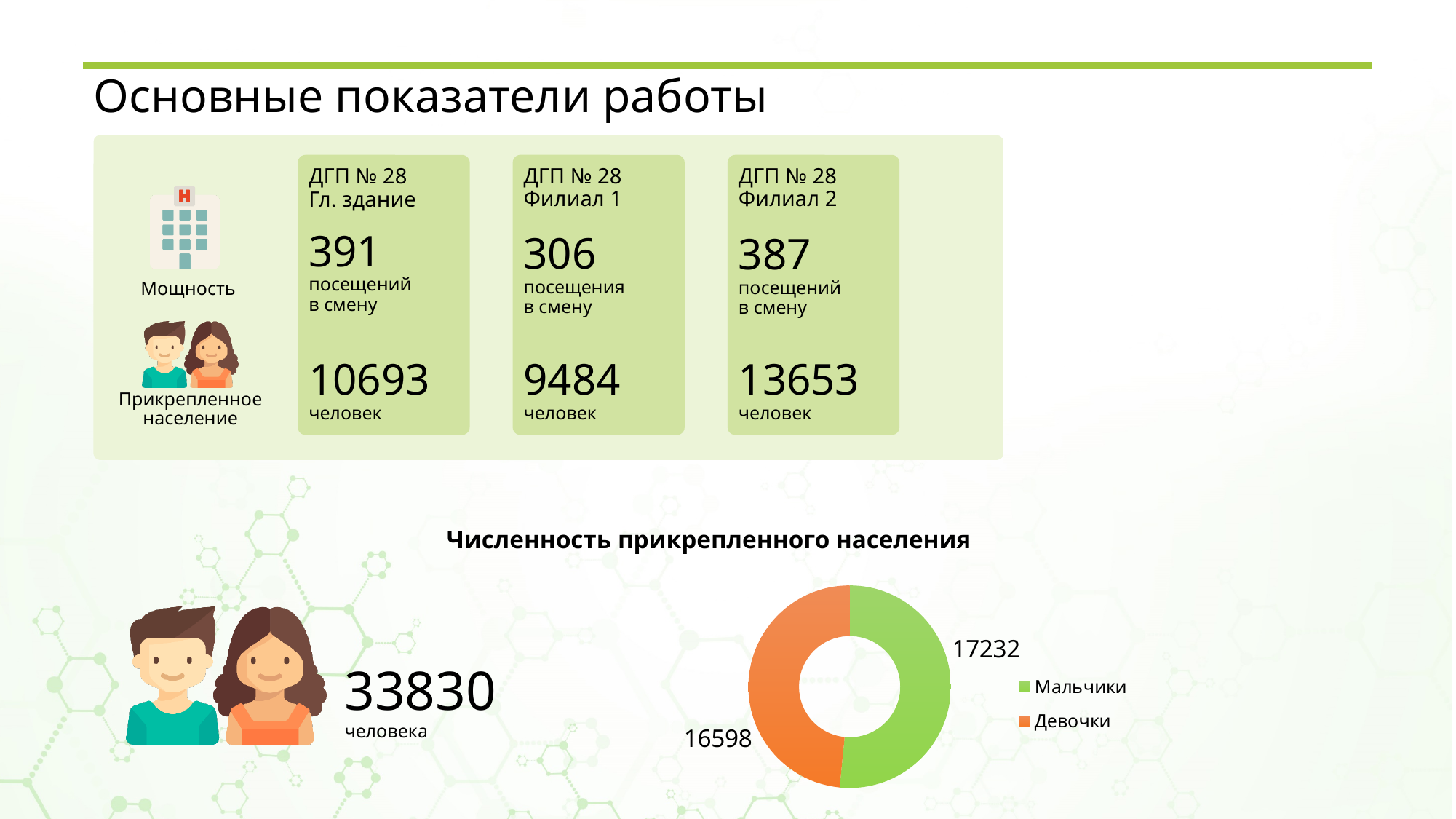
What is the value for Девочки in the chart 'Численность прикрепленного населения'? 16598 What kind of chart is 'Численность прикрепленного населения'? doughnut chart Which category has the smaller value in the chart 'Численность прикрепленного населения'? Девочки What is the total of the two slices in the chart 'Численность прикрепленного населения'? 33830 Which colour represents Девочки in the chart 'Численность прикрепленного населения'? orange How many categories are shown in the chart 'Численность прикрепленного населения'? 2 In the chart 'Численность прикрепленного населения', what is the difference between the values for Мальчики and Девочки? 634 What is the value for Мальчики in the chart 'Численность прикрепленного населения'? 17232 In the chart 'Численность прикрепленного населения', is the value for Мальчики larger or smaller than the value for Девочки? larger Which category has the larger value in the chart 'Численность прикрепленного населения'? Мальчики What is the title of the chart on the slide? Численность прикрепленного населения How many entries does the legend of the chart 'Численность прикрепленного населения' list? 2